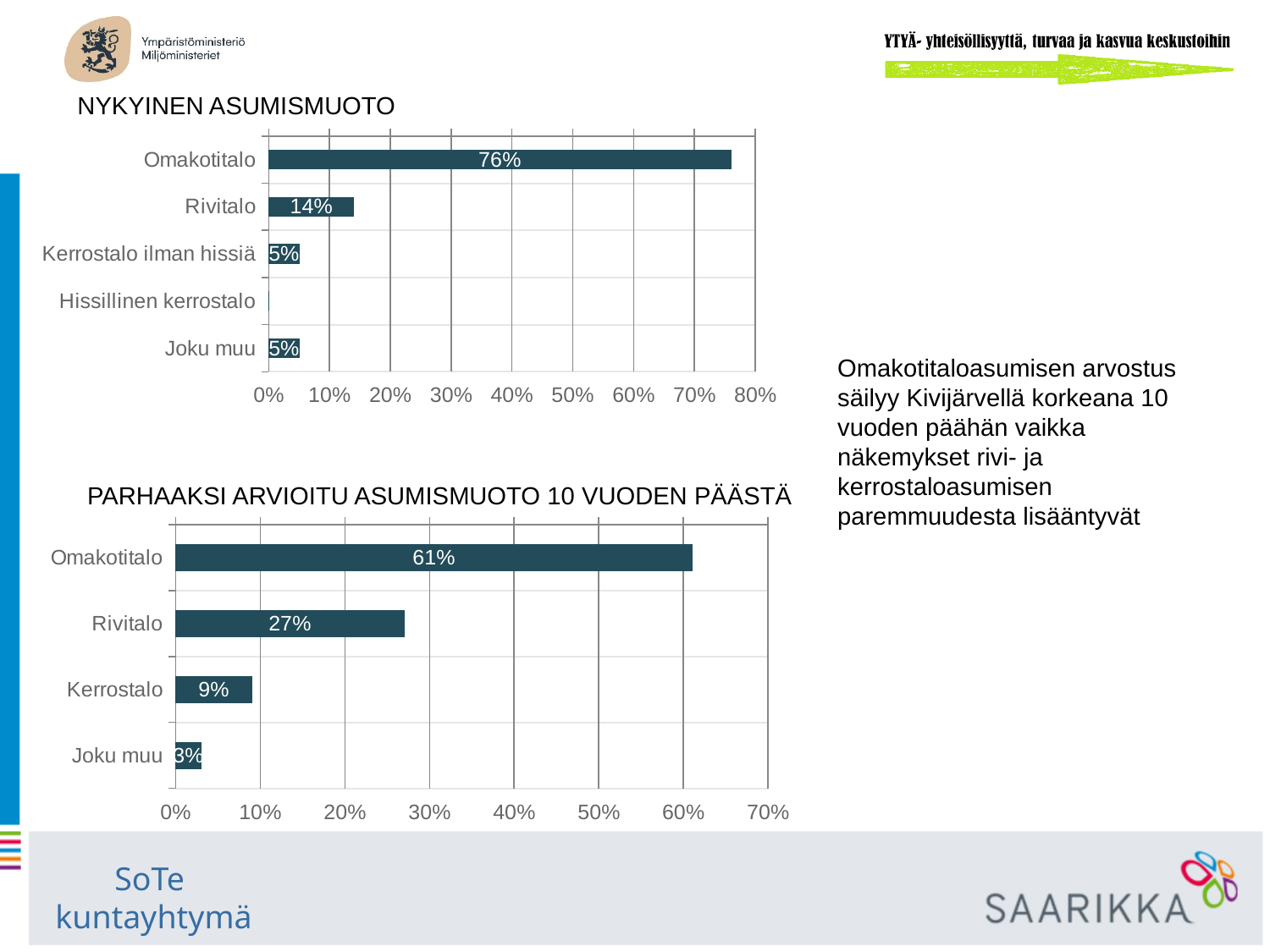
In the NYKYINEN ASUMISMUOTO chart, how many categories are listed on the vertical axis? 5 In the PARHAAKSI ARVIOITU ASUMISMUOTO 10 VUODEN PÄÄSTÄ chart, what is the difference between Omakotitalo and Rivitalo? 34% In the PARHAAKSI ARVIOITU ASUMISMUOTO 10 VUODEN PÄÄSTÄ chart, which category has the lowest value? Joku muu In the NYKYINEN ASUMISMUOTO chart, what is the value for Kerrostalo ilman hissiä? 5% Which is larger: Rivitalo in the NYKYINEN ASUMISMUOTO chart or Rivitalo in the PARHAAKSI ARVIOITU ASUMISMUOTO 10 VUODEN PÄÄSTÄ chart? PARHAAKSI ARVIOITU ASUMISMUOTO 10 VUODEN PÄÄSTÄ In the NYKYINEN ASUMISMUOTO chart, what is the value for Rivitalo? 14% In the NYKYINEN ASUMISMUOTO chart, what is the value for Omakotitalo? 76% In the PARHAAKSI ARVIOITU ASUMISMUOTO 10 VUODEN PÄÄSTÄ chart, what is the value for Kerrostalo? 9% In the NYKYINEN ASUMISMUOTO chart, what is the difference between Omakotitalo and Rivitalo? 62% In the PARHAAKSI ARVIOITU ASUMISMUOTO 10 VUODEN PÄÄSTÄ chart, what is the value for Rivitalo? 27% In the NYKYINEN ASUMISMUOTO chart, which category has the highest value? Omakotitalo What type of chart is the PARHAAKSI ARVIOITU ASUMISMUOTO 10 VUODEN PÄÄSTÄ chart? Bar chart